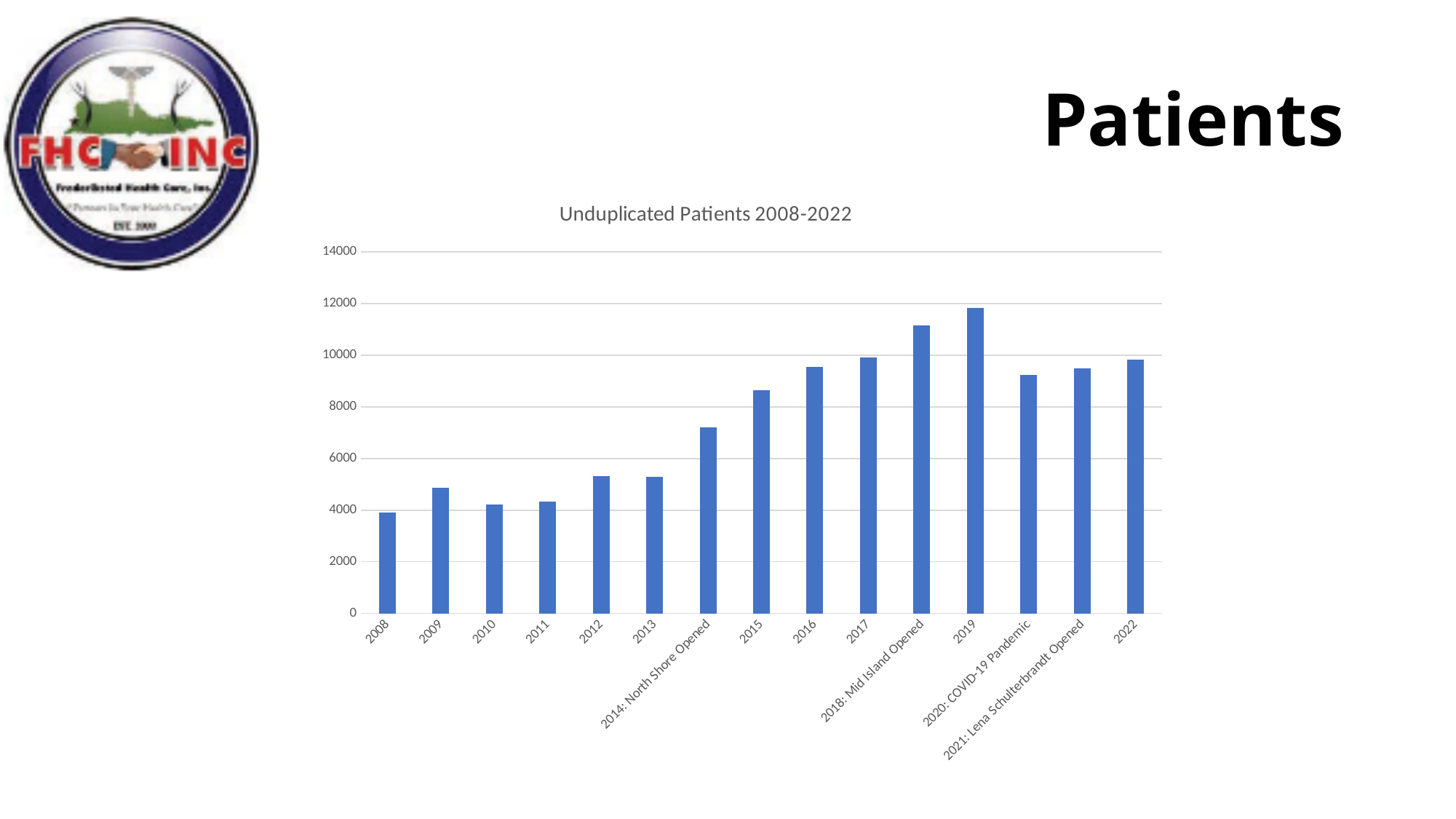
Which is larger, the value for 2009 or the value for 2010? 2009 Which is larger, the value for 2019 or the value for 2020: COVID-19 Pandemic? 2019 How many bars (years) are plotted in the chart? 15 What kind of chart is shown on the slide? bar chart Do the values generally rise or fall from 2008 to 2019? rise Which year has the lowest number of unduplicated patients? 2008 Is the value for 2015 greater or less than 8000? greater Is the value for 2020: COVID-19 Pandemic greater or less than 10000? less Which year has the highest number of unduplicated patients? 2019 Is the value for 2018: Mid Island Opened greater or less than 10000? greater What is the title of the chart? Unduplicated Patients 2008-2022